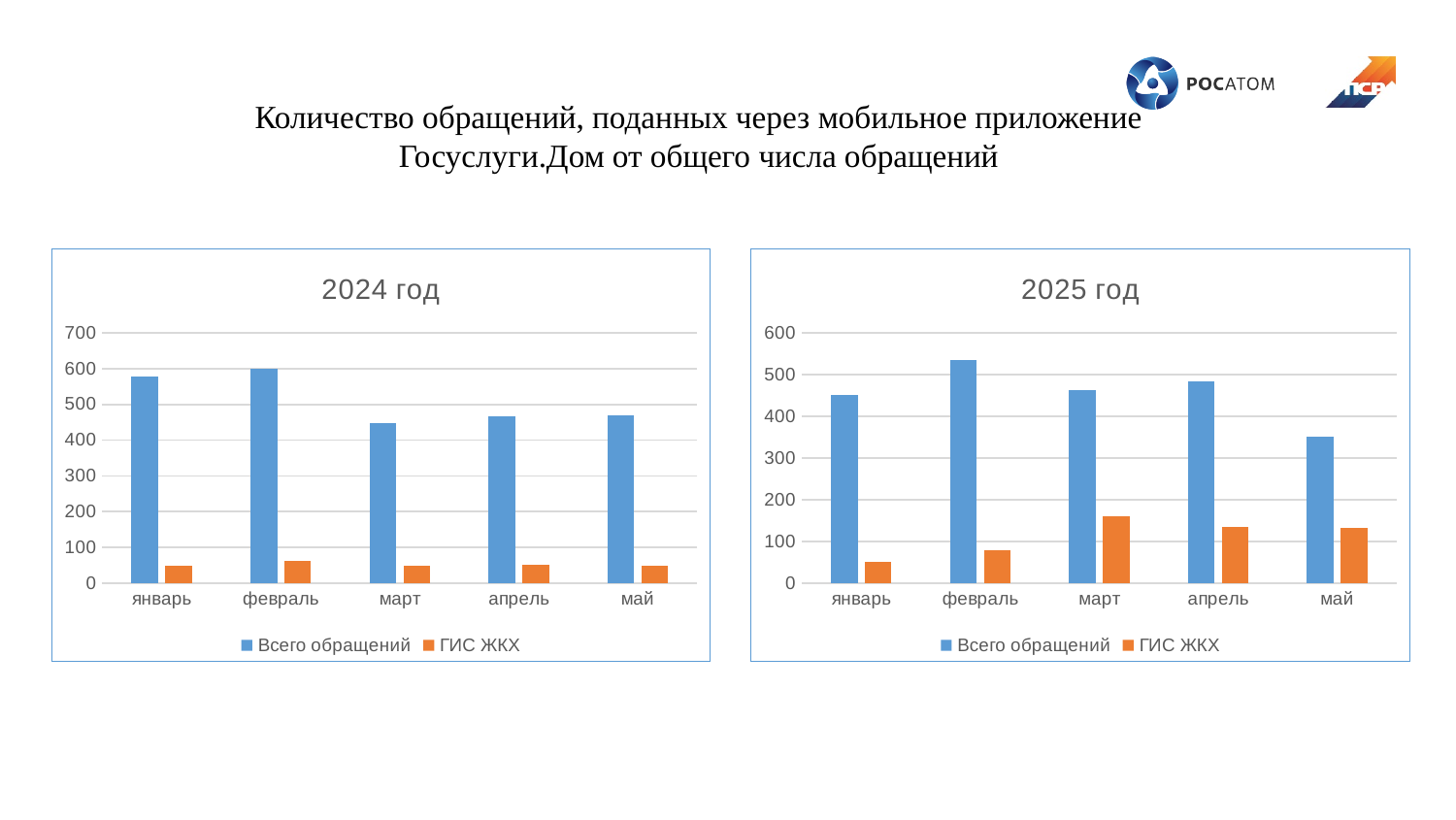
In the "2025 год" chart, which month has the highest value for Всего обращений? февраль In the "2025 год" chart, is the value for ГИС ЖКХ in март greater or less than 100? greater In the "2024 год" chart, which month has the highest value for Всего обращений? февраль In the "2025 год" chart, which is larger for ГИС ЖКХ: февраль or март? март In the "2025 год" chart, which month has the highest value for ГИС ЖКХ? март How many series does the legend of the "2025 год" chart list? 2 How many months are shown on the x axis of the "2024 год" chart? 5 In the "2025 год" chart, is the value for Всего обращений in май greater or less than 400? less In the "2024 год" chart, is the value for Всего обращений in январь greater or less than 500? greater In the "2025 год" chart, which month has the lowest value for Всего обращений? май What are the two legend entries in the "2024 год" chart? Всего обращений and ГИС ЖКХ What kind of chart is the "2024 год" chart? bar chart